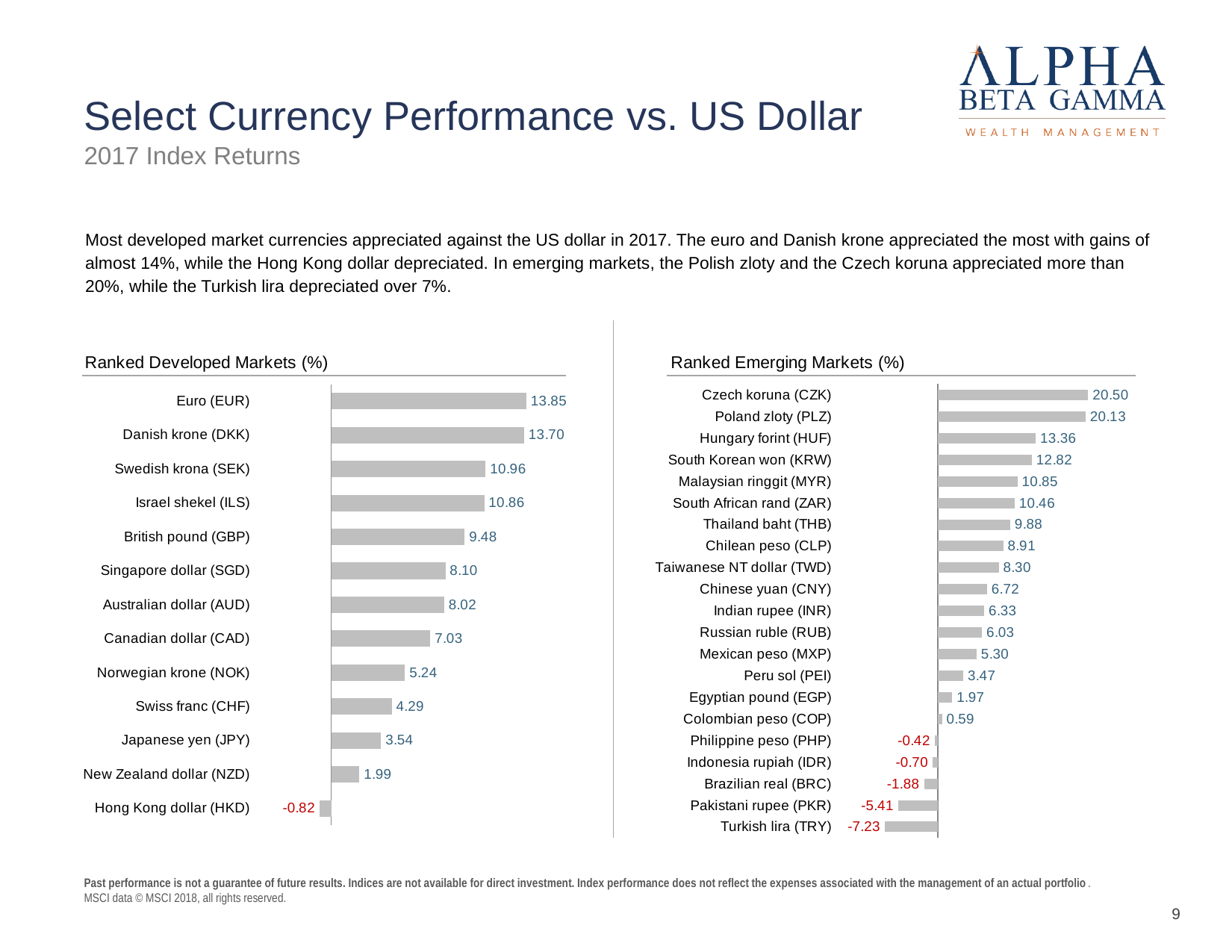
In the Ranked Developed Markets chart, which currency has the lowest value? Hong Kong dollar (HKD) In the Ranked Emerging Markets chart, which is larger, the value for the Thailand baht (THB) or the Chilean peso (CLP)? Thailand baht (THB) In the Ranked Developed Markets chart, what is the difference between the Euro (EUR) and the Danish krone (DKK)? 0.15 In the Ranked Emerging Markets chart, what is the value for the Turkish lira (TRY)? -7.23 What type of chart is the Ranked Emerging Markets chart? Bar chart In the Ranked Developed Markets chart, which currency has the highest value? Euro (EUR) In the Ranked Emerging Markets chart, which currency has the highest value? Czech koruna (CZK) In the Ranked Emerging Markets chart, what is the difference between the Czech koruna (CZK) and the Poland zloty (PLZ)? 0.37 In the Ranked Emerging Markets chart, what is the value for the Mexican peso (MXP)? 5.30 How many currencies are shown in the Ranked Emerging Markets chart? 21 In the Ranked Developed Markets chart, what is the value for the British pound (GBP)? 9.48 How many currencies are shown in the Ranked Developed Markets chart? 13